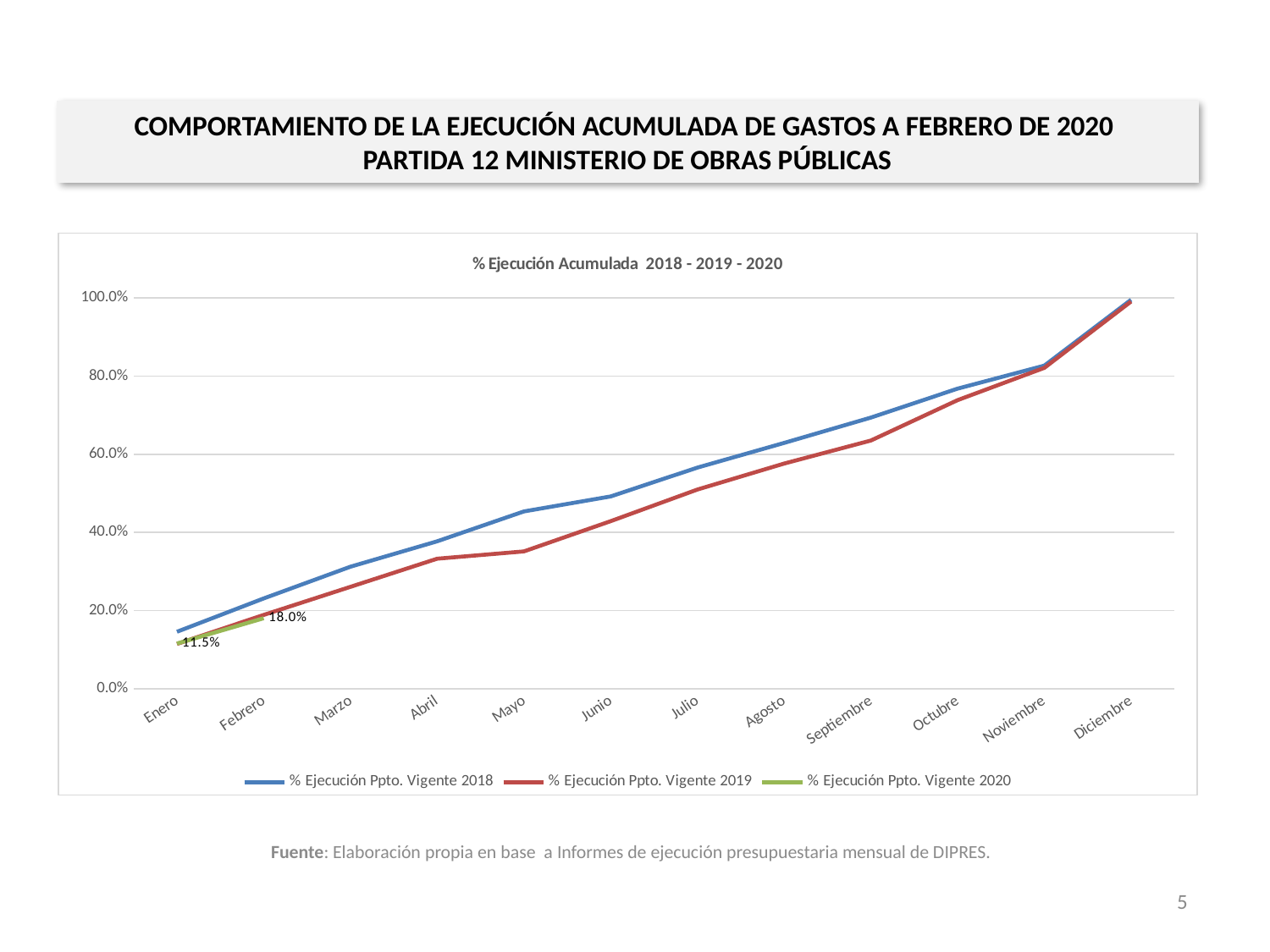
By how much did the % Ejecución Ppto. Vigente 2020 series increase from Enero to Febrero? 6.5% Which month has the highest value for the % Ejecución Ppto. Vigente 2018 series? Diciembre What is the value for Febrero in the % Ejecución Ppto. Vigente 2020 series? 18.0% What kind of chart is shown on the slide? Line chart Is the value for Mayo in the % Ejecución Ppto. Vigente 2019 series greater or less than 40.0%? less In Mayo, which series has the larger value: % Ejecución Ppto. Vigente 2018 or % Ejecución Ppto. Vigente 2019? % Ejecución Ppto. Vigente 2018 How many months are shown on the x axis of the chart? 12 What is the value for Enero in the % Ejecución Ppto. Vigente 2020 series? 11.5% Do the values for the % Ejecución Ppto. Vigente 2018 series rise or fall from Enero to Diciembre? Rise What is the title of the chart? % Ejecución Acumulada 2018 - 2019 - 2020 How many series does the legend list? 3 Is the value for Mayo in the % Ejecución Ppto. Vigente 2018 series greater or less than 40.0%? greater